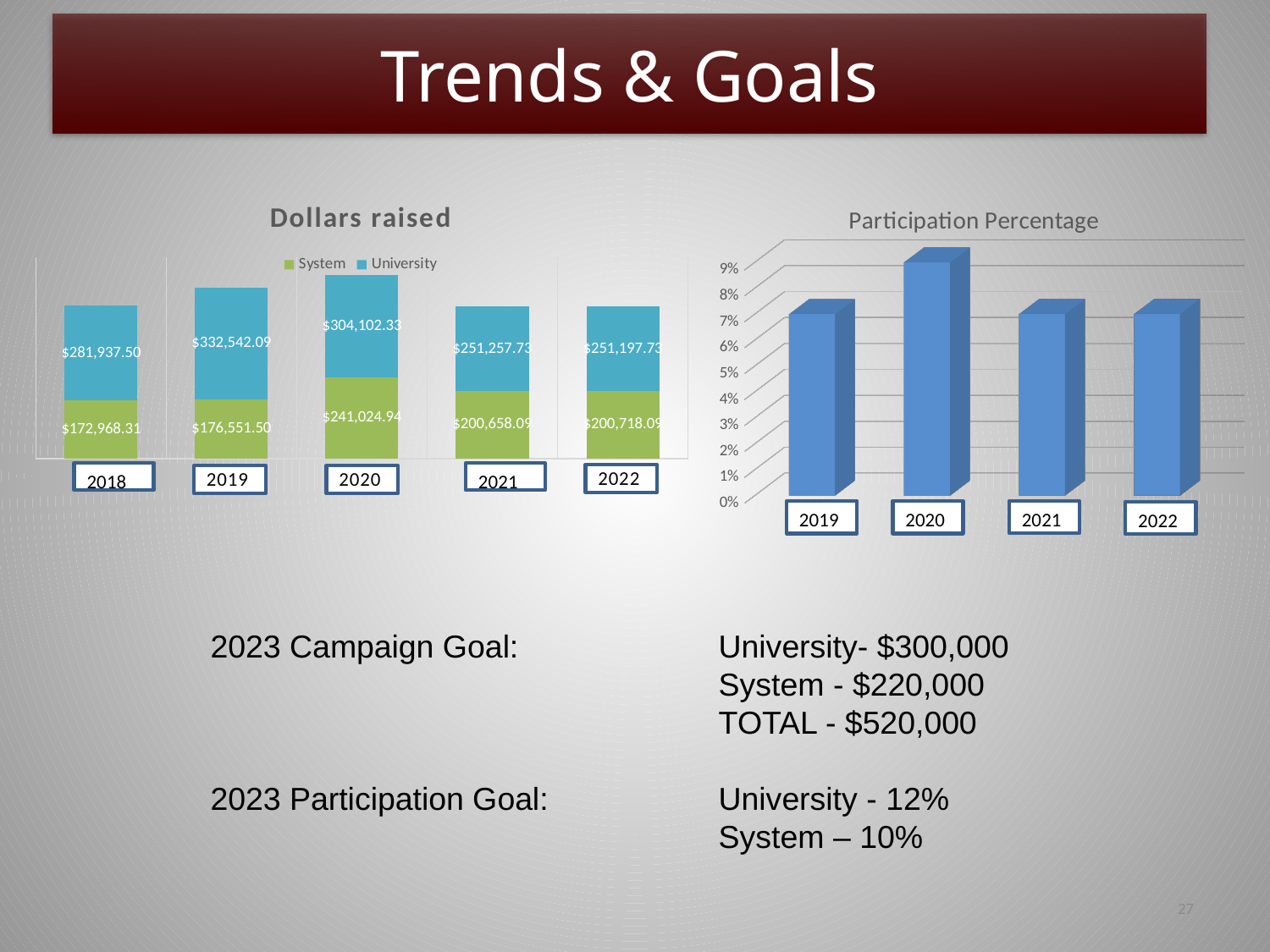
In the Participation Percentage chart, which year has the highest value? 2020 In the Dollars raised chart, what is the System value for 2018? $172,968.31 In the Participation Percentage chart, is the value for 2019 greater or less than 8%? less In the Dollars raised chart, what is the System value for 2020? $241,024.94 In the Dollars raised chart, which year has the highest University value? 2019 How many years are shown in the Participation Percentage chart? 4 In the Dollars raised chart, what is the total of the stacked bar for 2020? $545,127.27 How many series does the legend of the Dollars raised chart list? 2 In the Dollars raised chart, which is larger: the System value for 2020 or the System value for 2021? System value for 2020 In the Dollars raised chart, what is the difference between the University values for 2019 and 2018? $50,604.59 In the Dollars raised chart, which year has the lowest System value? 2018 In the Dollars raised chart, what is the University value for 2019? $332,542.09